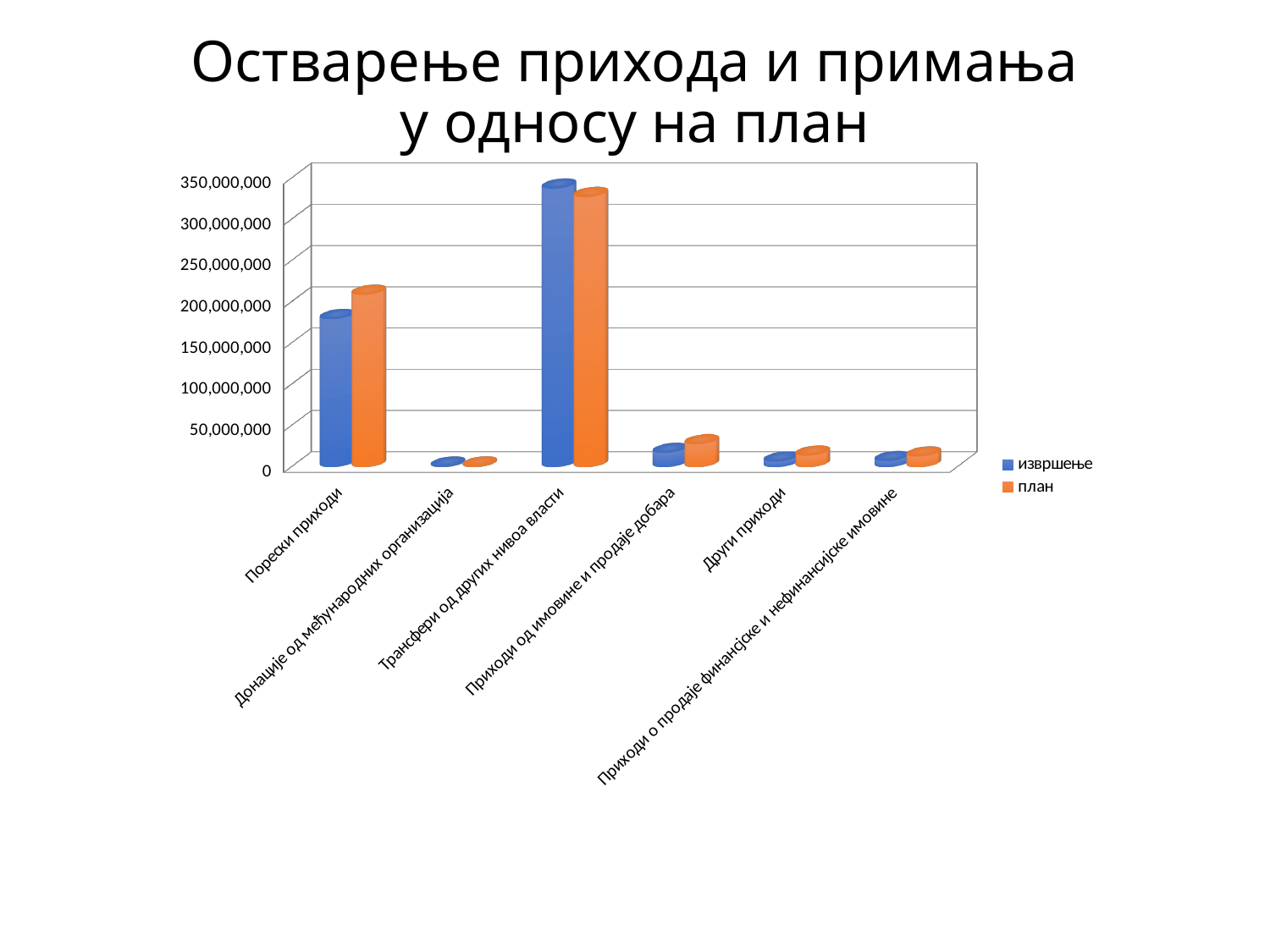
Is the извршење value for Порески приходи greater or less than 200,000,000? less How many categories are shown on the x axis? 6 What kind of chart is shown on the slide? bar chart Is the извршење value for Трансфери од других нивоа власти greater or less than 300,000,000? greater Which category has the highest value for извршење? Трансфери од других нивоа власти How many series does the legend list? 2 Which category has the lowest value for извршење? Донације од међународних организација Which colour represents the план series in the legend? orange For Порески приходи, which is larger: извршење or план? план Which category has the highest value for план? Трансфери од других нивоа власти Is the план value for Порески приходи greater or less than 200,000,000? greater For Трансфери од других нивоа власти, which is larger: извршење or план? извршење